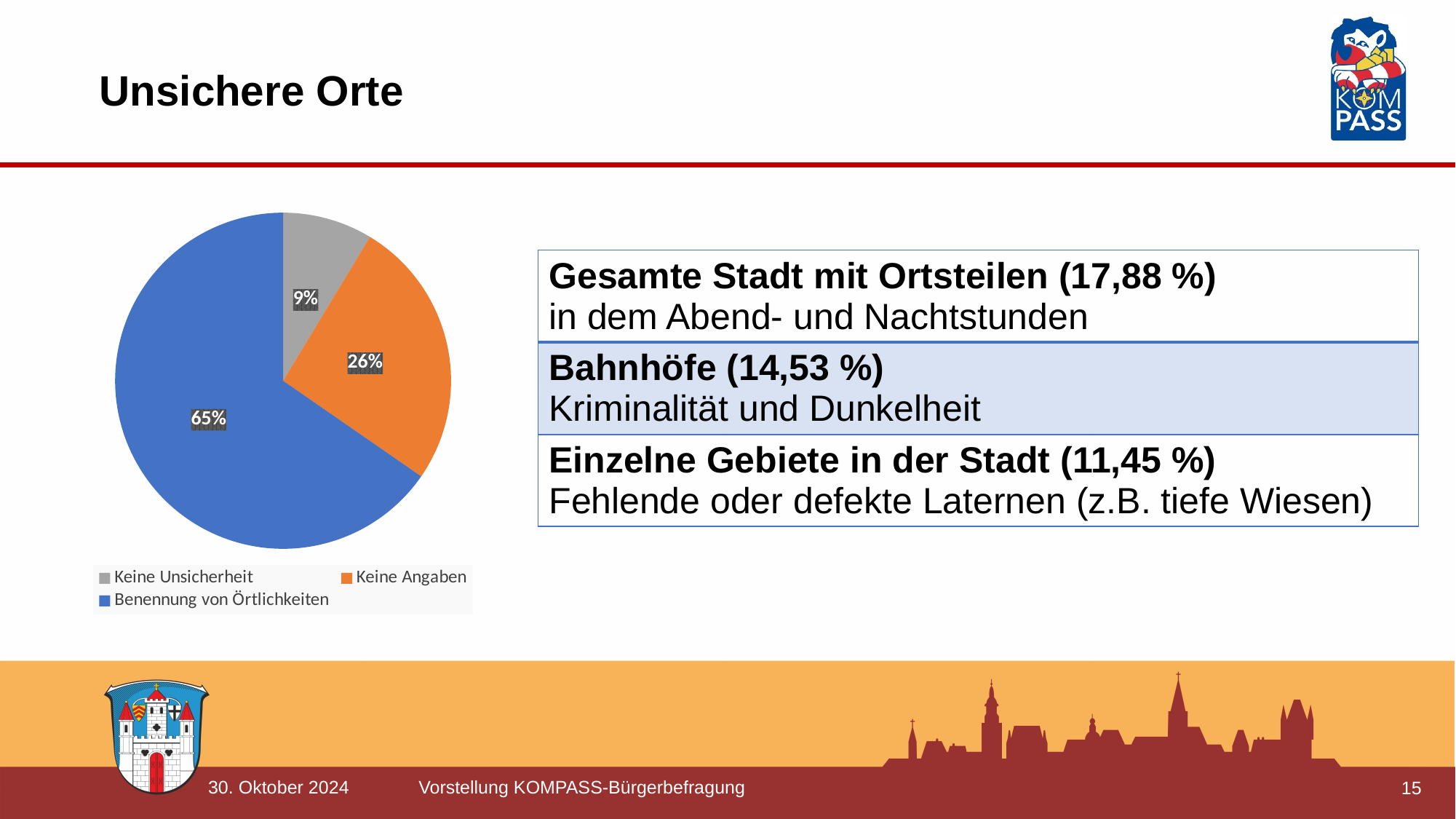
What share of the pie does "Keine Unsicherheit" have? 9% Which is larger, the slice for "Keine Angaben" or the slice for "Keine Unsicherheit"? Keine Angaben What colour is the slice for "Keine Angaben"? orange What colour is the slice for "Benennung von Örtlichkeiten"? blue How many categories does the pie chart have? 3 What kind of chart is shown on the slide? pie chart Which category has the smallest slice of the pie? Keine Unsicherheit What share of the pie does "Benennung von Örtlichkeiten" have? 65% Which category has the largest slice of the pie? Benennung von Örtlichkeiten What is the difference in percentage points between "Benennung von Örtlichkeiten" and "Keine Angaben"? 39 What share of the pie does "Keine Angaben" have? 26% What is the difference in percentage points between "Keine Angaben" and "Keine Unsicherheit"? 17